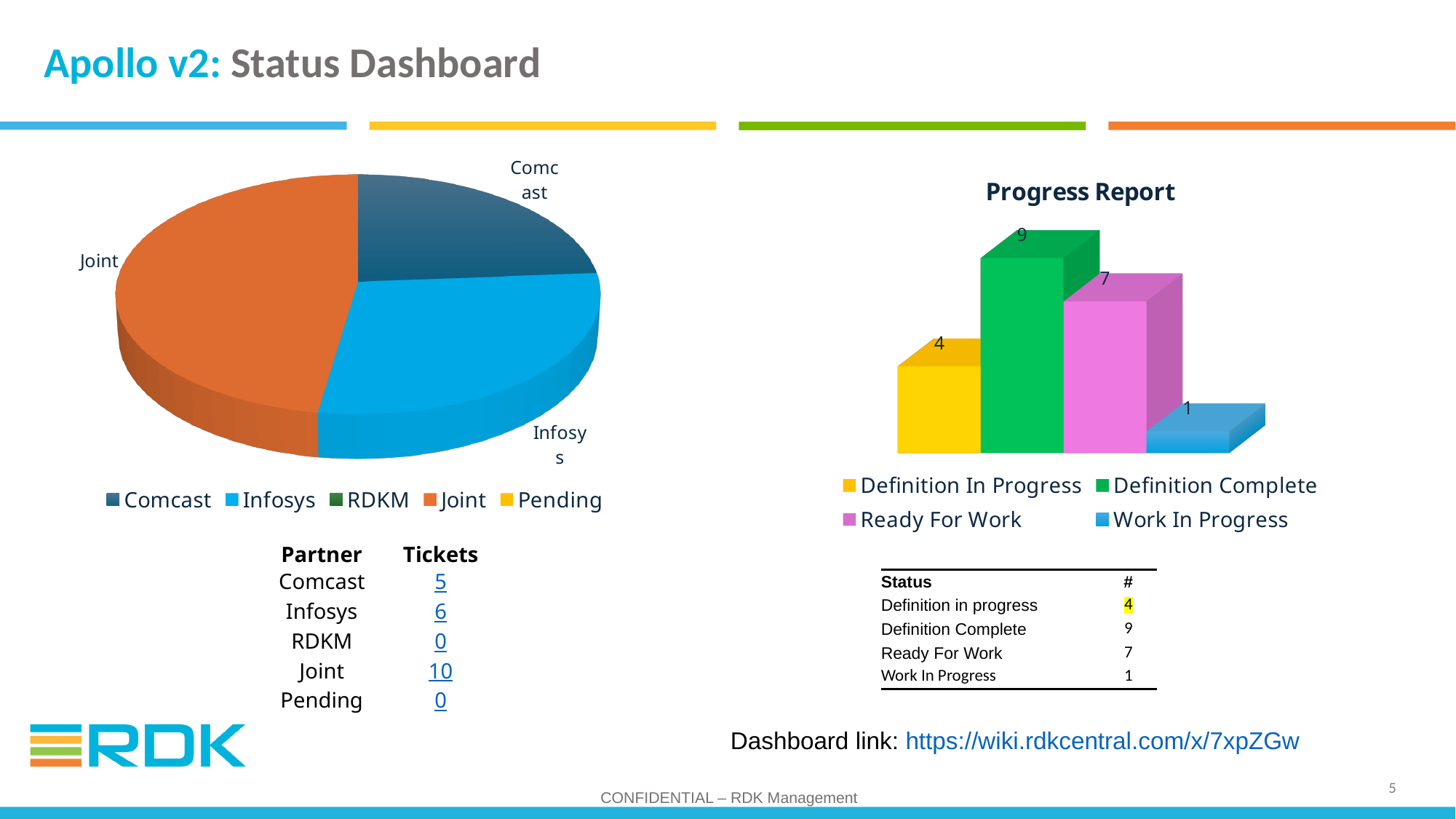
In the pie chart on the left, which slice is larger, Joint or Infosys? Joint In the Progress Report chart, which category has the lowest value? Work In Progress In the Progress Report chart, what is the difference between Definition Complete and Definition In Progress? 5 In the Progress Report chart, which category has the highest value? Definition Complete In the Progress Report chart, how many bars are plotted? 4 What type of chart is the Progress Report chart? bar chart In the Progress Report chart, what is the value for Ready For Work? 7 In the Progress Report chart, what is the value for Work In Progress? 1 In the pie chart on the left, which partner has the largest slice? Joint In the Progress Report chart, what is the value for Definition Complete? 9 How many entries does the legend of the pie chart on the left list? 5 What type of chart is the chart on the left of the slide? pie chart